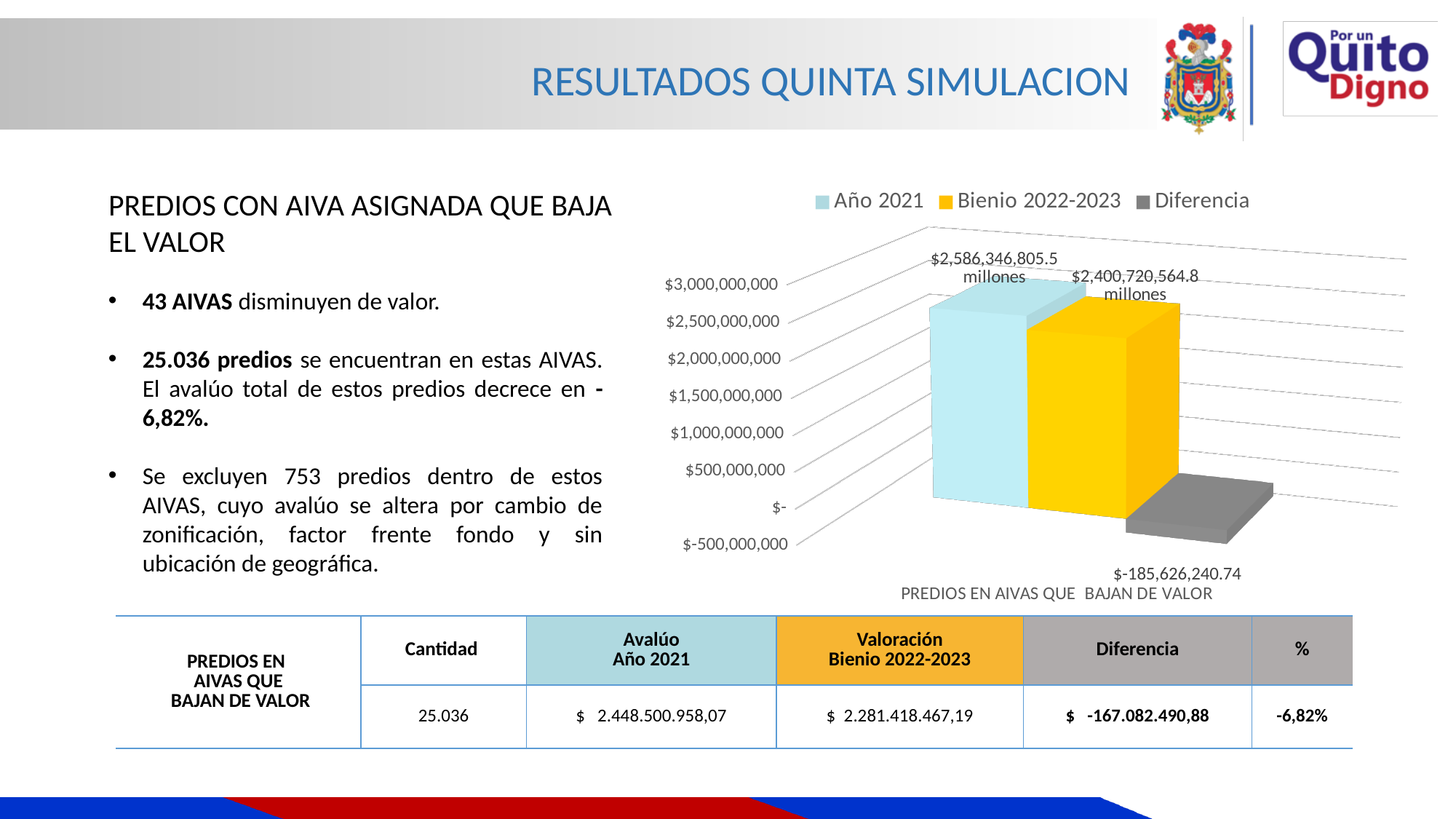
What is the value shown for the Bienio 2022-2023 series in the chart? $2,400,720,564.8 millones How many series does the chart legend list? 3 Which series has the highest value in the chart? Año 2021 What type of chart is shown on the slide? bar chart What is the value shown for the Diferencia series in the chart? $-185,626,240.74 Is the value for Diferencia in the chart greater or less than $-500,000,000? greater What are the three series listed in the chart legend? Año 2021, Bienio 2022-2023, Diferencia What is the category label shown on the x axis of the chart? PREDIOS EN AIVAS QUE BAJAN DE VALOR In the chart, is the value for Año 2021 larger or smaller than the value for Bienio 2022-2023? larger Which series has the lowest value in the chart? Diferencia What is the value shown for the Año 2021 series in the chart? $2,586,346,805.5 millones Is the value for Bienio 2022-2023 in the chart greater or less than $2,500,000,000? less